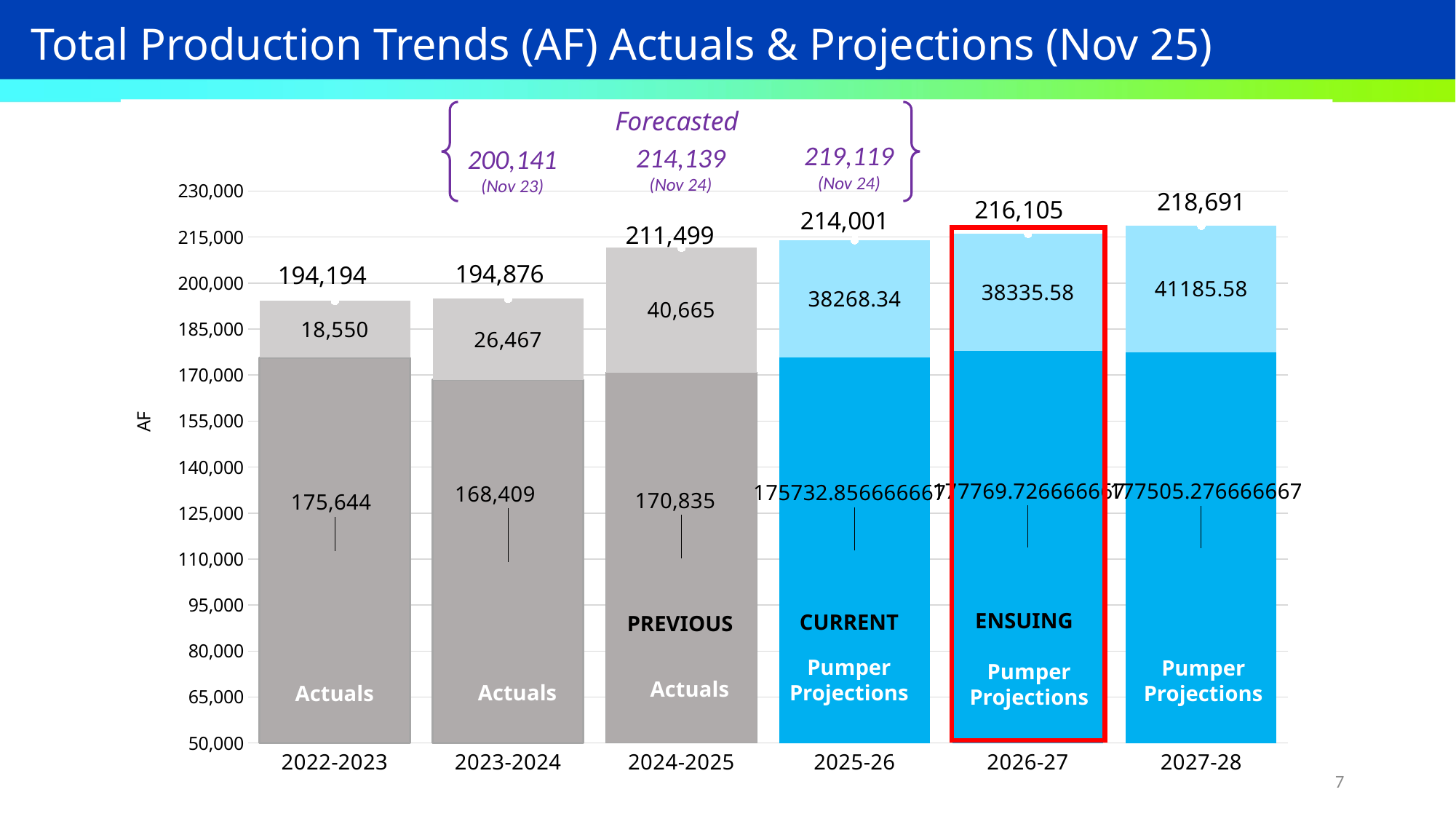
Which fiscal year's bar is outlined with a red box? 2026-27 What is the value of the lower (dark grey) segment of the 2022-2023 bar? 175,644 Which fiscal year has the lowest total production value? 2022-2023 How many fiscal-year categories are plotted along the x axis? 6 Which is larger, the upper segment of the 2024-2025 bar or the upper segment of the 2022-2023 bar? 2024-2025 What is the value of the upper (light grey) segment of the 2023-2024 bar? 26,467 Which fiscal year has the highest total production value? 2027-28 Do the total production values rise or fall from 2022-2023 to 2027-28? rise What is the difference between the total for 2026-27 and the total for 2025-26? 2,104 What type of chart is shown on the slide? stacked bar chart What is the value of the upper (light blue) segment of the 2027-28 bar? 41185.58 What is the total production value labelled above the 2024-2025 bar? 211,499